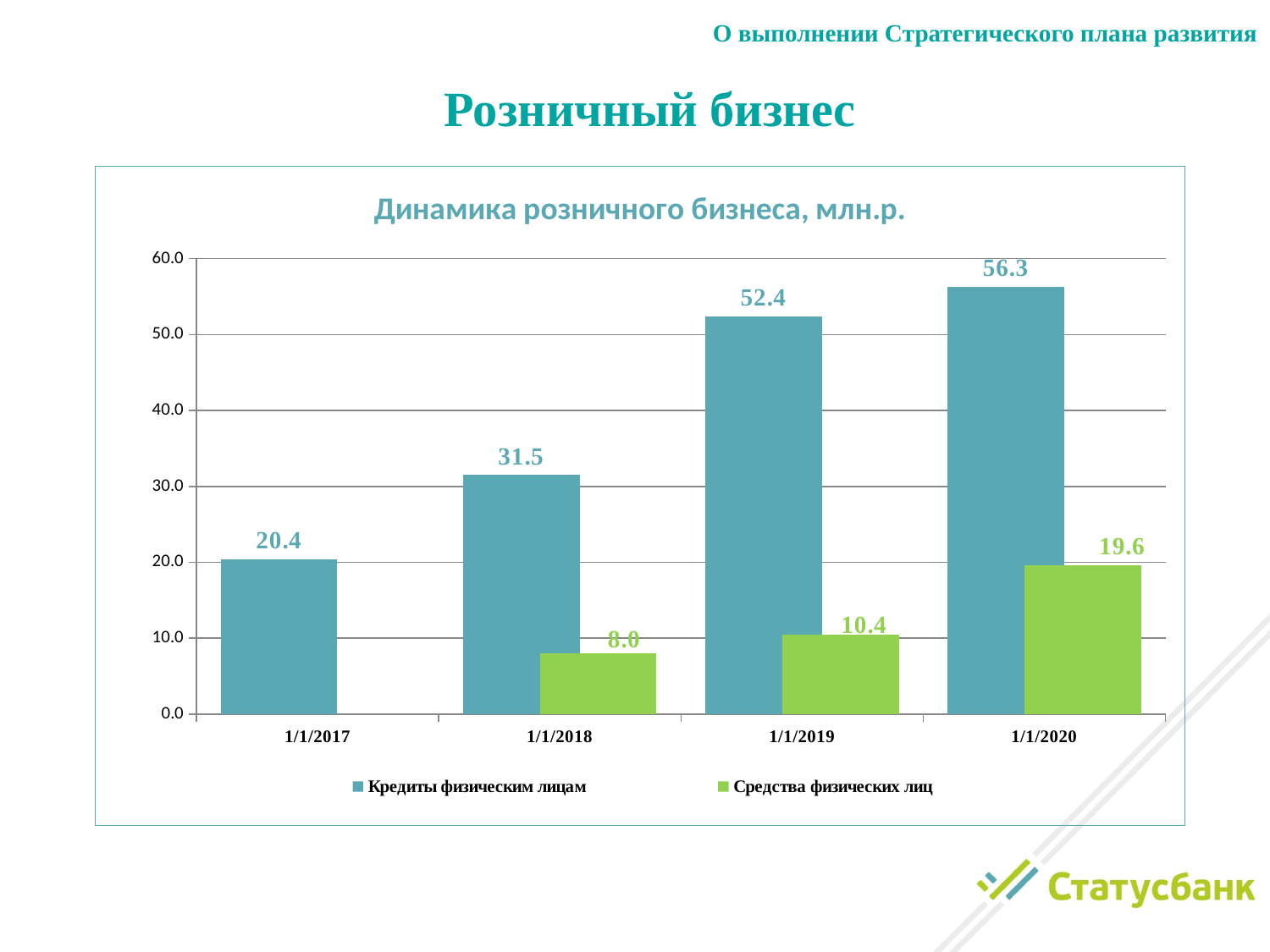
How many dates are shown on the x axis? 4 What is the value of Кредиты физическим лицам for 1/1/2019? 52.4 Is the value of Кредиты физическим лицам for 1/1/2019 greater or less than 50.0? greater What is the difference between Кредиты физическим лицам and Средства физических лиц for 1/1/2020? 36.7 Which date has the highest value for Кредиты физическим лицам? 1/1/2020 What is the value of Кредиты физическим лицам for 1/1/2017? 20.4 What kind of chart is shown? bar chart Do the values for Кредиты физическим лицам rise or fall from 1/1/2017 to 1/1/2020? rise Which is larger for 1/1/2018: Кредиты физическим лицам or Средства физических лиц? Кредиты физическим лицам What is the value of Средства физических лиц for 1/1/2020? 19.6 How many series does the legend list? 2 Which date has the lowest value for Средства физических лиц? 1/1/2018